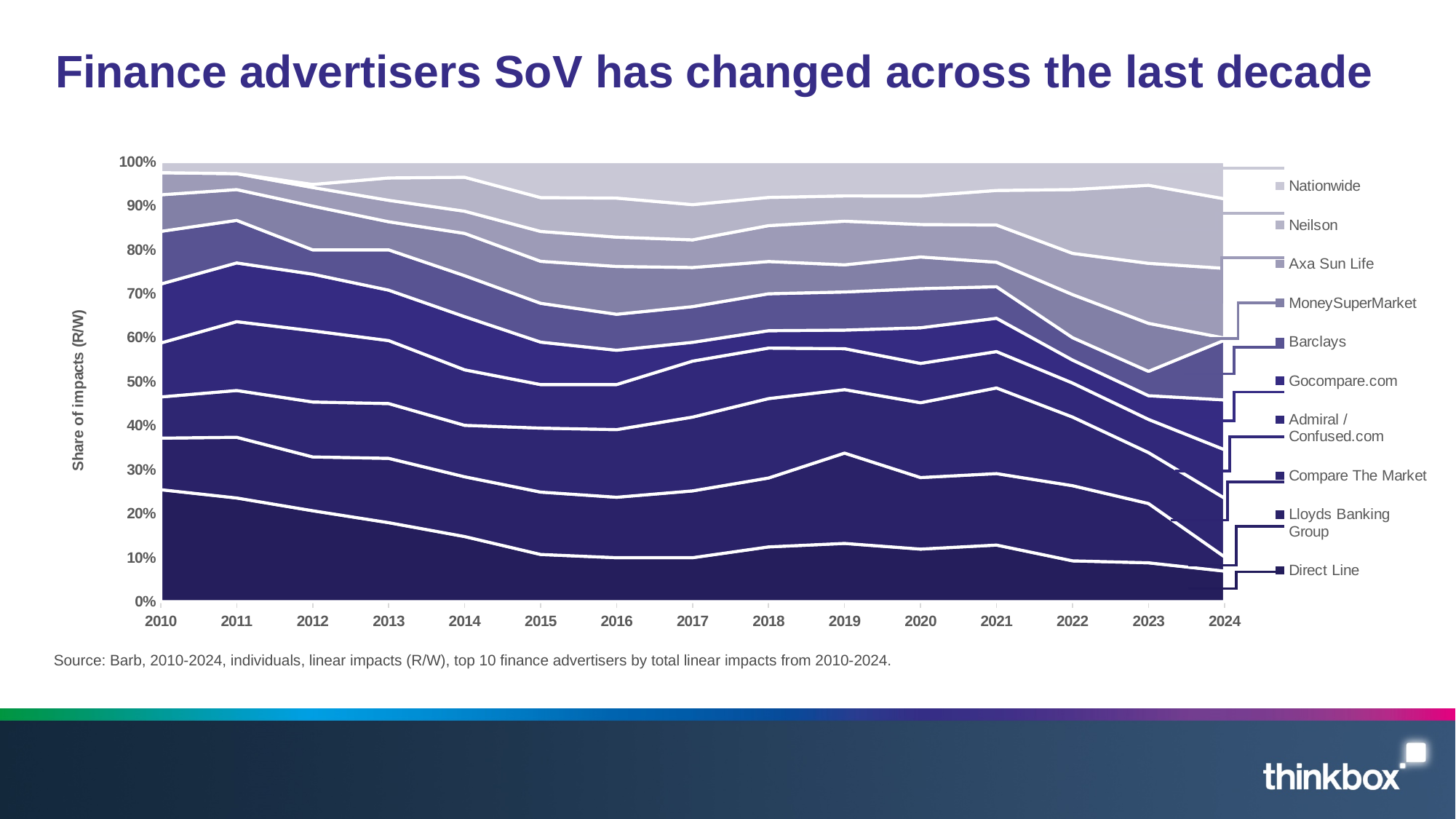
What is the highest value shown on the y axis? 100% How many years are plotted along the x axis? 15 Which advertiser is the bottom band of the stacked area chart? Direct Line What is the label of the y axis? Share of impacts (R/W) Is Direct Line's share of impacts larger in 2010 or in 2024? 2010 What is the first year shown on the x axis? 2010 How many series does the legend list? 10 Is Direct Line's share of impacts in 2010 greater or less than 20%? greater Is Direct Line's share of impacts in 2024 greater or less than 10%? less What kind of chart is shown on the slide? Stacked area chart What is the last year shown on the x axis? 2024 Does Direct Line's share of impacts rise or fall from 2010 to 2024? Fall